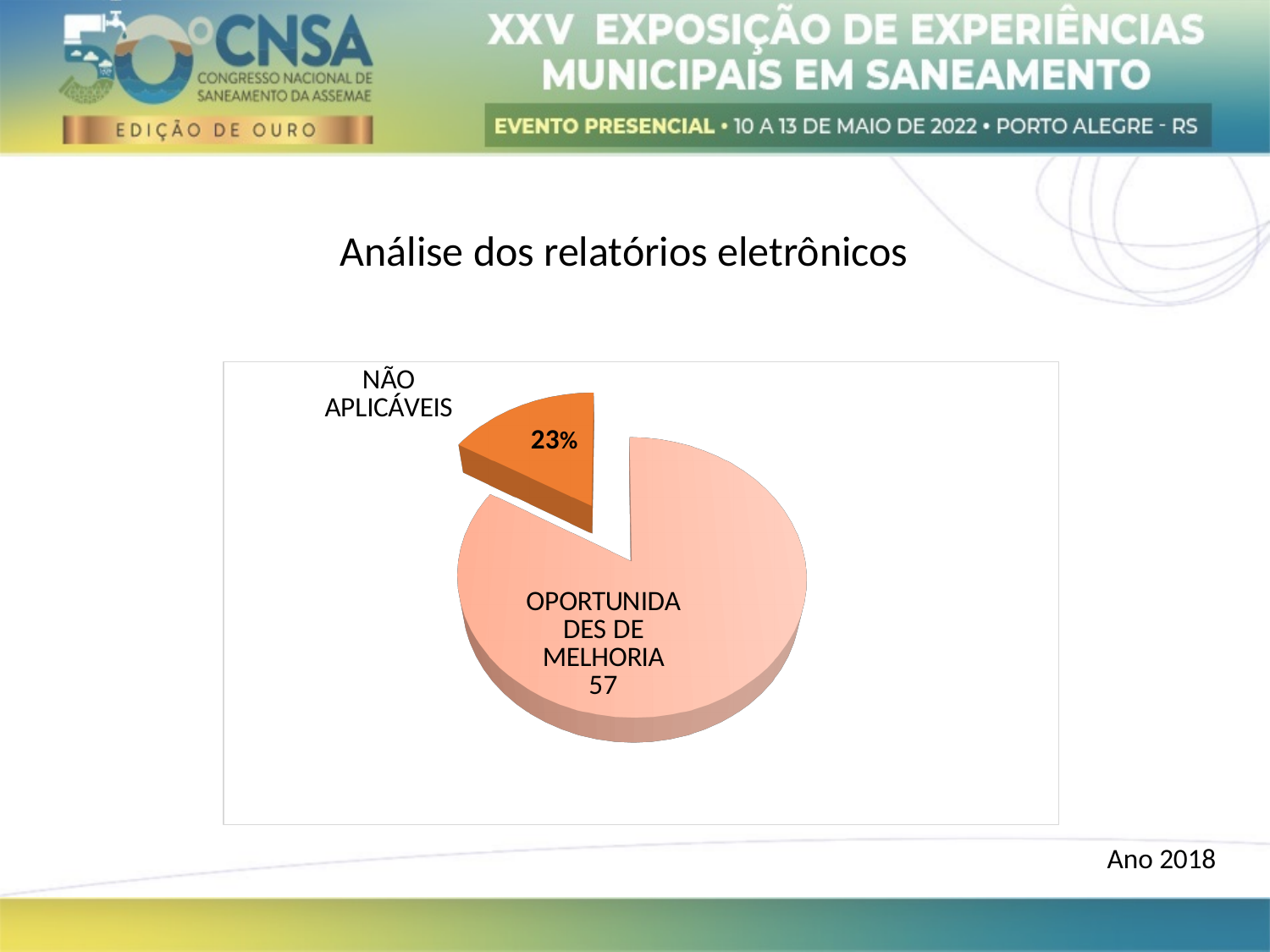
What colour is the NÃO APLICÁVEIS slice of the pie chart? orange Which slice is larger in the pie chart, NÃO APLICÁVEIS or OPORTUNIDADES DE MELHORIA? OPORTUNIDADES DE MELHORIA Which slice of the pie chart is the largest? OPORTUNIDADES DE MELHORIA How many slices does the pie chart have? 2 What is the title shown above the pie chart? Análise dos relatórios eletrônicos Which slice of the pie chart is the smallest? NÃO APLICÁVEIS What value is printed on the OPORTUNIDADES DE MELHORIA slice of the pie chart? 57 What kind of chart is shown on the slide? pie chart What value is printed on the NÃO APLICÁVEIS slice of the pie chart? 23% What share of the pie does the NÃO APLICÁVEIS slice represent? 23%